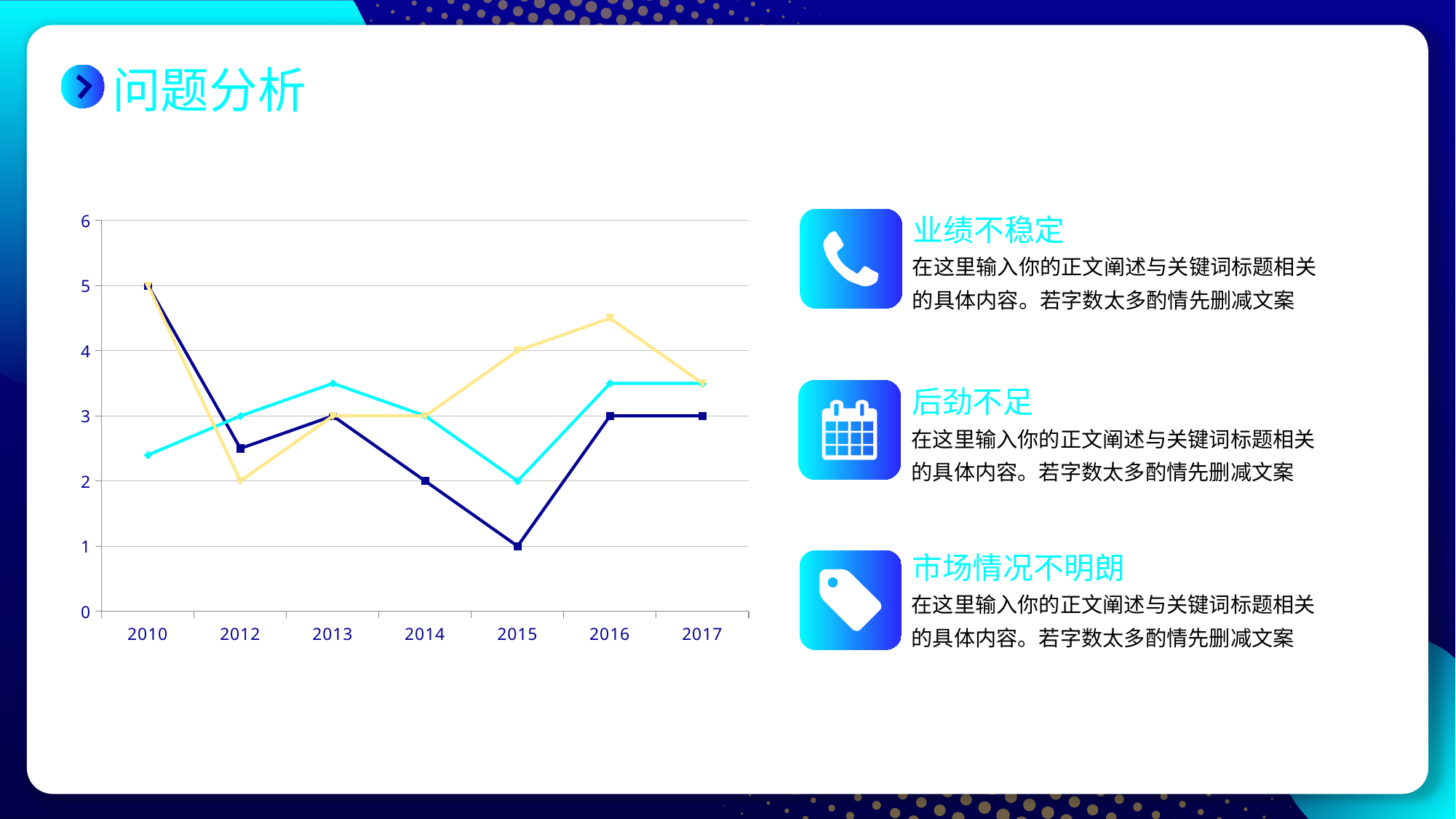
How many years are shown on the x axis of the chart? 7 What is the value of the dark blue line in 2015? 1 What is the value of the cyan line in 2012? 3 What kind of chart is shown on the slide? line chart In which year does the dark blue line reach its lowest value? 2015 What is the value of the yellow line in 2015? 4 Does the dark blue line rise or fall from 2010 to 2012? fall In which year does the yellow line reach its highest value? 2016 What is the value of the dark blue line in 2010? 5 In 2015, which line has the higher value, the yellow line or the dark blue line? the yellow line Is the value of the yellow line in 2016 greater or less than 4? greater How many lines are plotted on the chart? 3